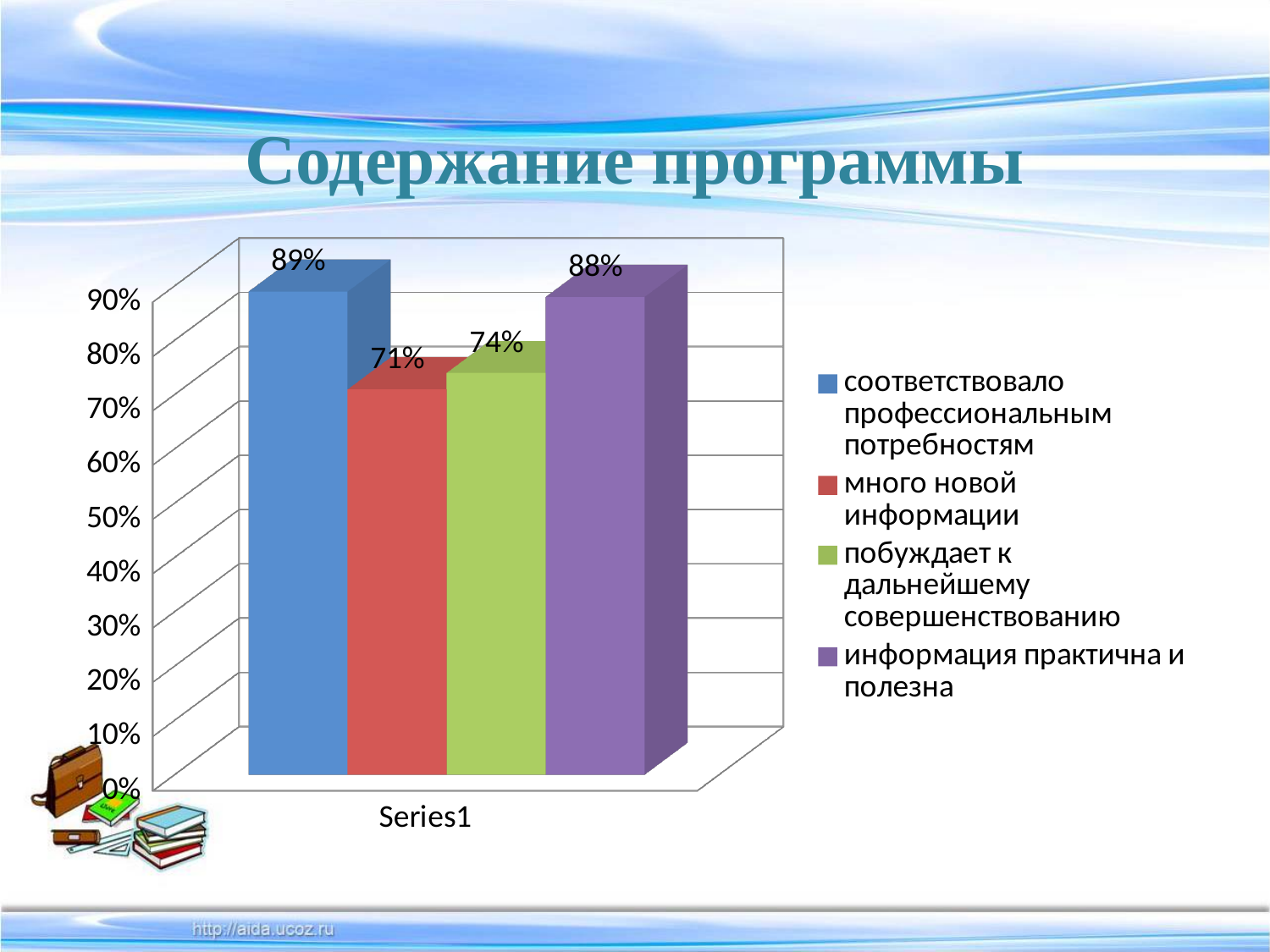
Which legend entry has the highest value? соответствовало профессиональным потребностям Which is larger: the value for "побуждает к дальнейшему совершенствованию" or the value for "много новой информации"? побуждает к дальнейшему совершенствованию Which legend entry has the lowest value? много новой информации What is the difference between the values for "соответствовало профессиональным потребностям" and "много новой информации"? 18% How many bars are plotted in the chart? 4 What kind of chart is shown on the slide? bar chart What value is shown for "много новой информации"? 71% What value is shown for "соответствовало профессиональным потребностям"? 89% What value is shown for "побуждает к дальнейшему совершенствованию"? 74% What value is shown for "информация практична и полезна"? 88% How many entries does the legend list? 4 What is the title of the slide? Содержание программы